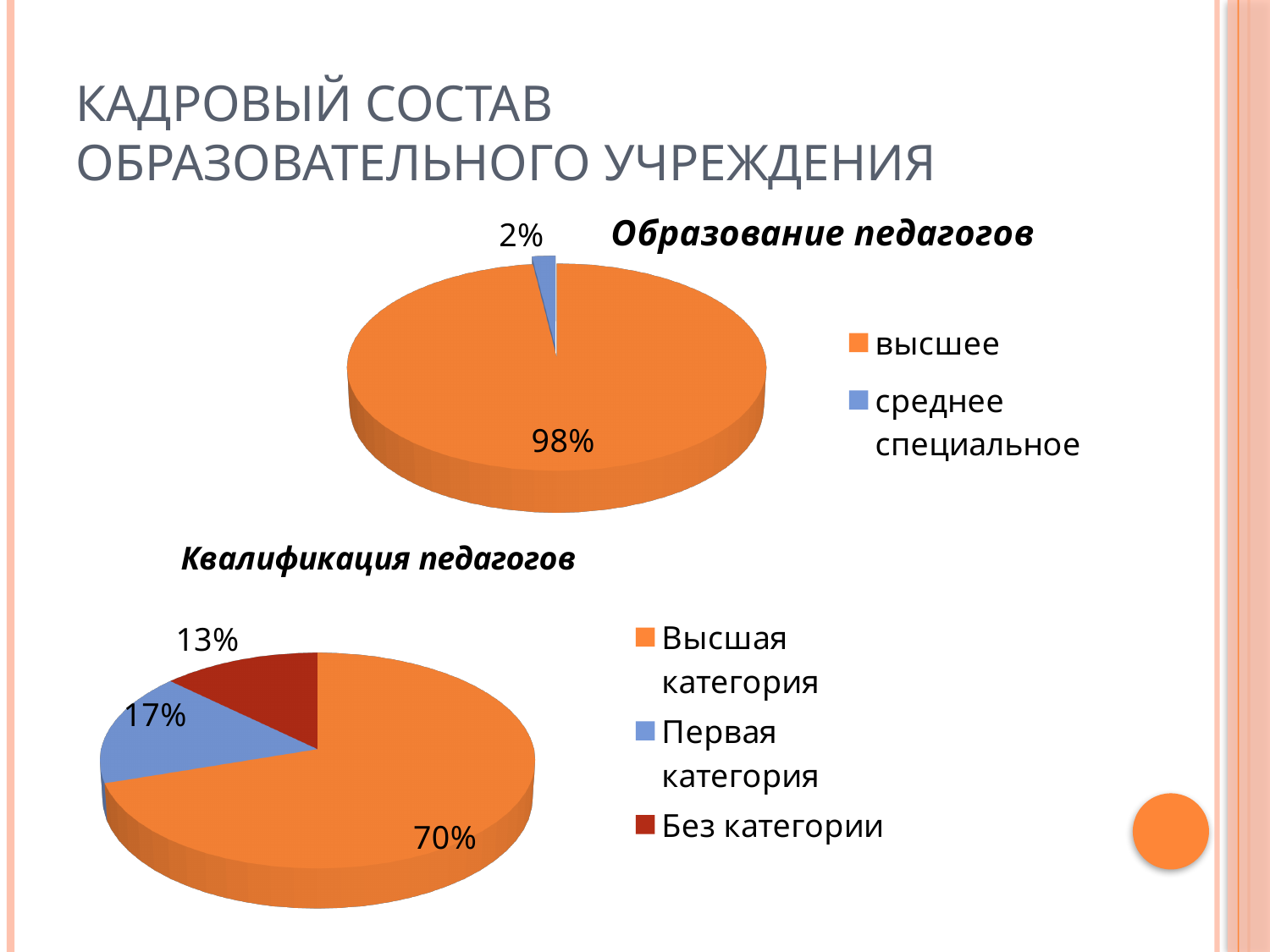
In the 'Образование педагогов' chart, how many slices does the pie have? 2 In the 'Квалификация педагогов' chart, which category has the smallest slice? Без категории In the 'Квалификация педагогов' chart, what share is labelled for 'Первая категория'? 17% In the 'Образование педагогов' chart, what share is labelled for 'высшее'? 98% In the 'Квалификация педагогов' chart, what share is labelled for 'Высшая категория'? 70% In the 'Образование педагогов' chart, which category has the largest slice? высшее What kind of chart is 'Квалификация педагогов'? pie chart In the 'Образование педагогов' chart, what share is labelled for 'среднее специальное'? 2% In the 'Квалификация педагогов' chart, what is the difference between the shares of 'Первая категория' and 'Без категории'? 4% In the 'Квалификация педагогов' chart, which colour represents 'Без категории'? dark red In the 'Квалификация педагогов' chart, what share is labelled for 'Без категории'? 13% In the 'Квалификация педагогов' chart, how many entries does the legend list? 3